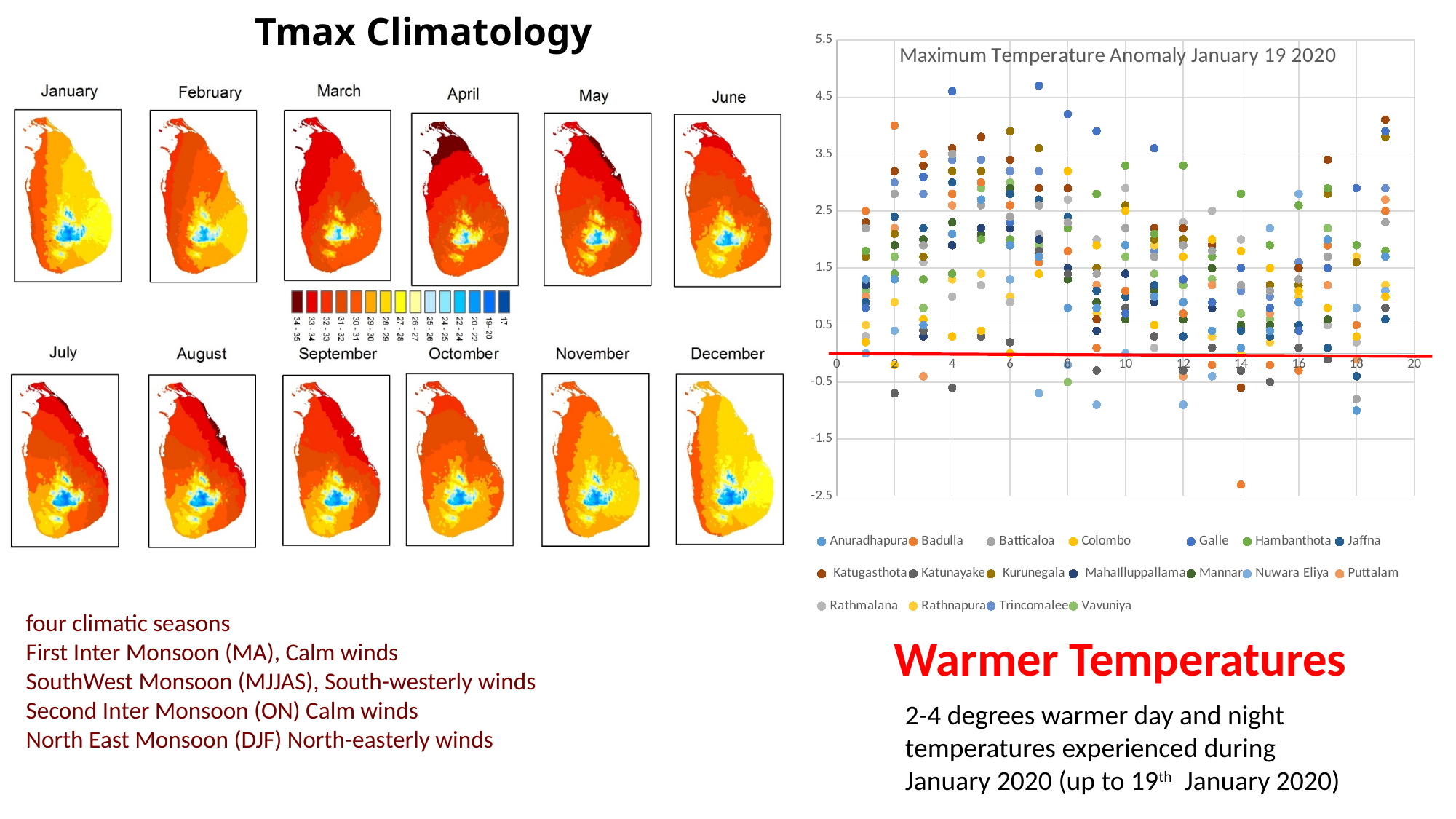
In the Maximum Temperature Anomaly chart, is the highest point at x = 1 greater or less than 3.5? less How many series does the legend of the Maximum Temperature Anomaly chart list? 18 In the Maximum Temperature Anomaly chart, what is the highest value shown on the vertical axis? 5.5 In the Maximum Temperature Anomaly chart, is the highest point at x = 8 greater or less than 4.5? less In the Maximum Temperature Anomaly chart, is the highest plotted point greater or less than 3.5? greater In the Maximum Temperature Anomaly chart, which is larger: the highest point at x = 8 or the highest point at x = 12? the highest point at x = 8 What kind of chart is the chart titled "Maximum Temperature Anomaly January 19 2020"? scatter chart In the Maximum Temperature Anomaly chart, which is lower: the lowest point at x = 14 or the lowest point at x = 2? the lowest point at x = 14 What is the title of the chart on the right side of the slide? Maximum Temperature Anomaly January 19 2020